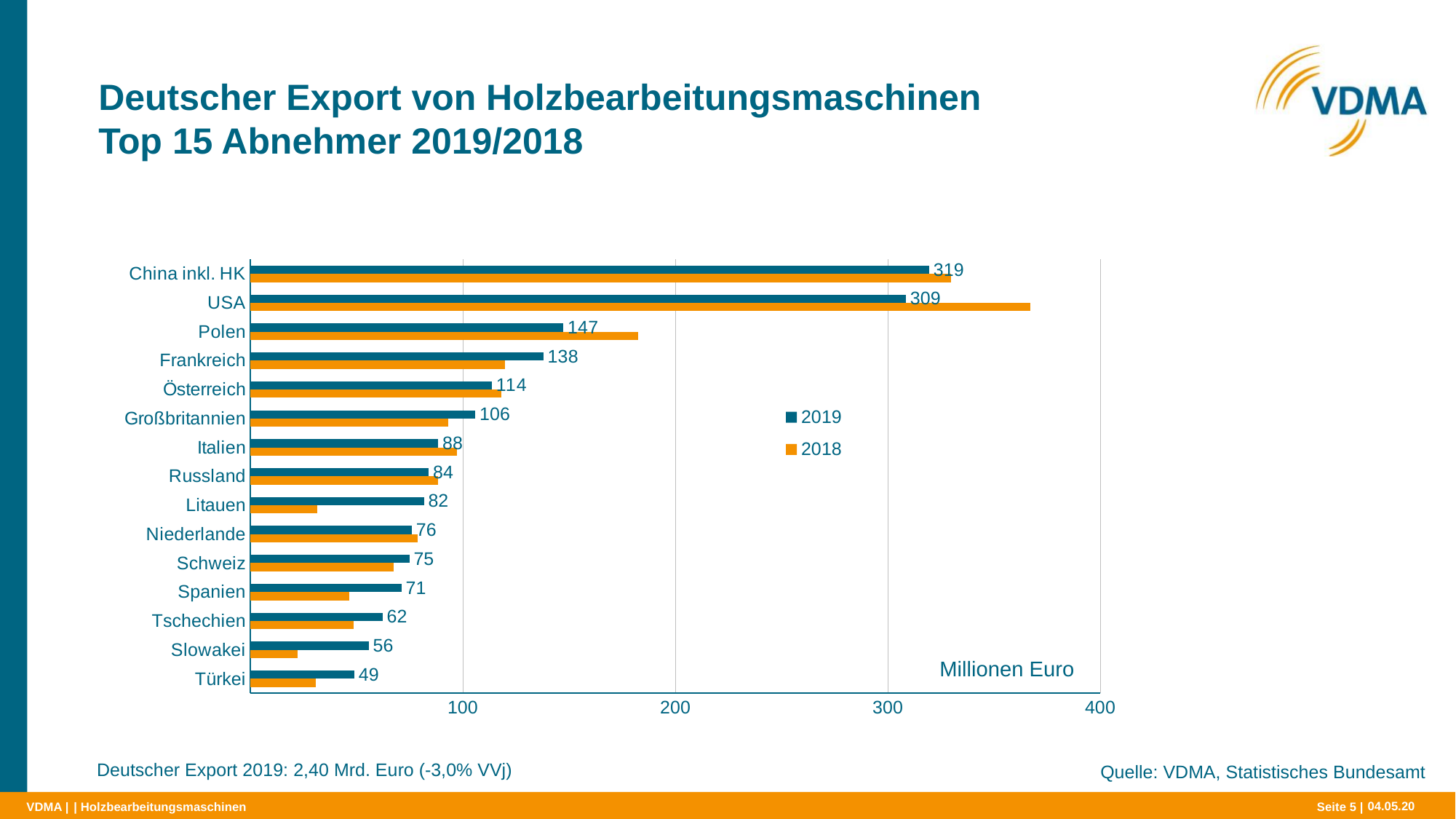
Is the 2018 value for Slowakei greater or less than 100? less For USA, which series has the larger value, 2019 or 2018? 2018 What unit is stated on the chart for the values? Millionen Euro What is the 2019 export value for Polen? 147 Which country has the highest 2019 export value? China inkl. HK How many countries are shown on the chart? 15 What is the 2019 export value for Litauen? 82 How many series does the legend list? 2 What is the difference between the 2019 values for China inkl. HK and USA? 10 What kind of chart is shown on the slide? bar chart Which country has the lowest 2019 export value? Türkei Is the 2018 value for USA greater or less than 300? greater